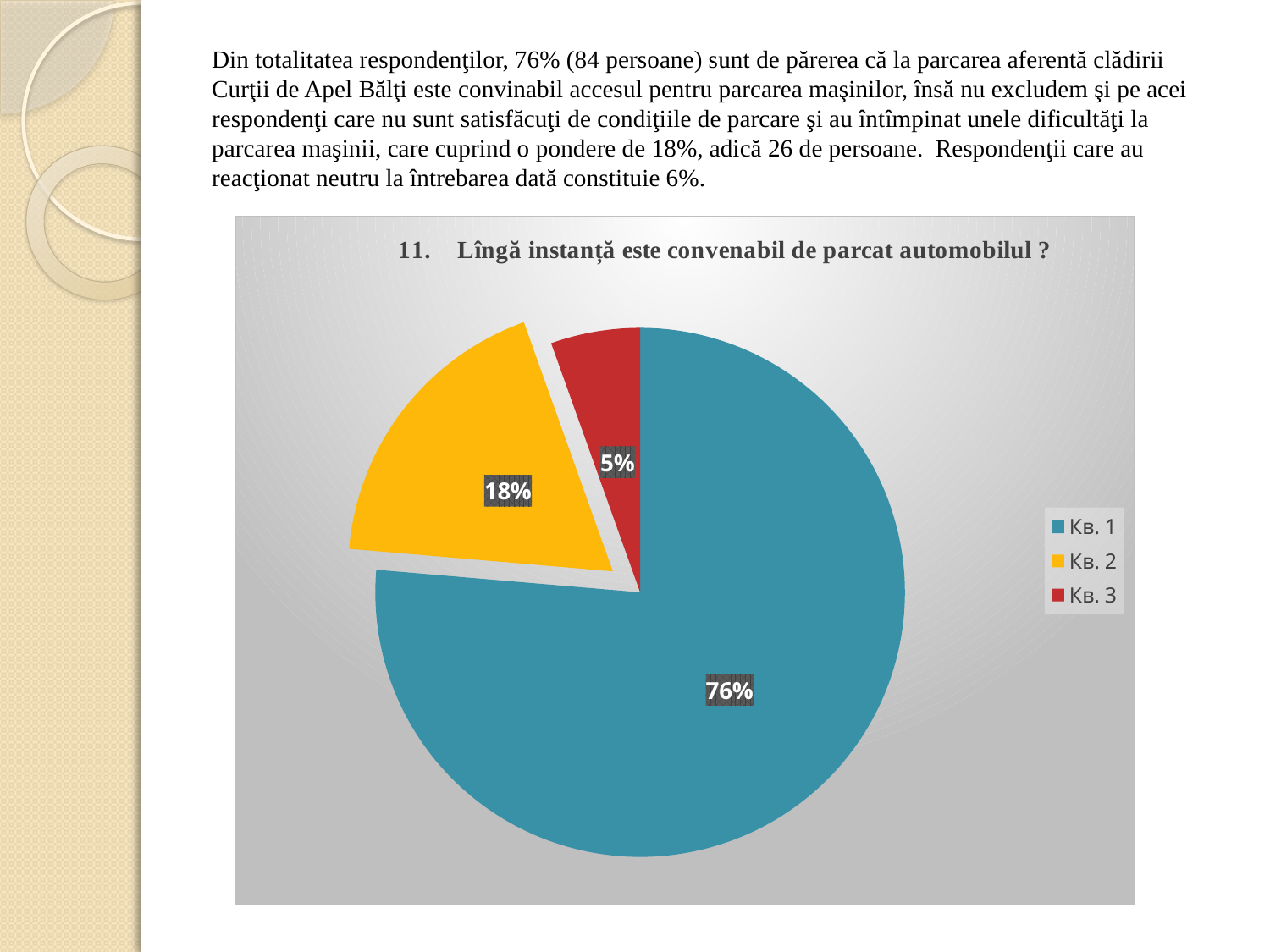
What is the value shown for Кв. 3 in the pie chart? 5% What is the difference between the values for Кв. 1 and Кв. 2? 58% What is the value shown for Кв. 2 in the pie chart? 18% Which category has the largest slice of the pie chart? Кв. 1 Which is larger, the slice for Кв. 2 or the slice for Кв. 3? Кв. 2 What kind of chart is shown on the slide? pie chart What is the value shown for Кв. 1 in the pie chart? 76% What is the title of the chart? 11. Lîngă instanță este convenabil de parcat automobilul ? What colour is the slice for Кв. 2? yellow How many slices does the pie chart have? 3 Which category has the smallest slice of the pie chart? Кв. 3 What is the difference between the values for Кв. 2 and Кв. 3? 13%